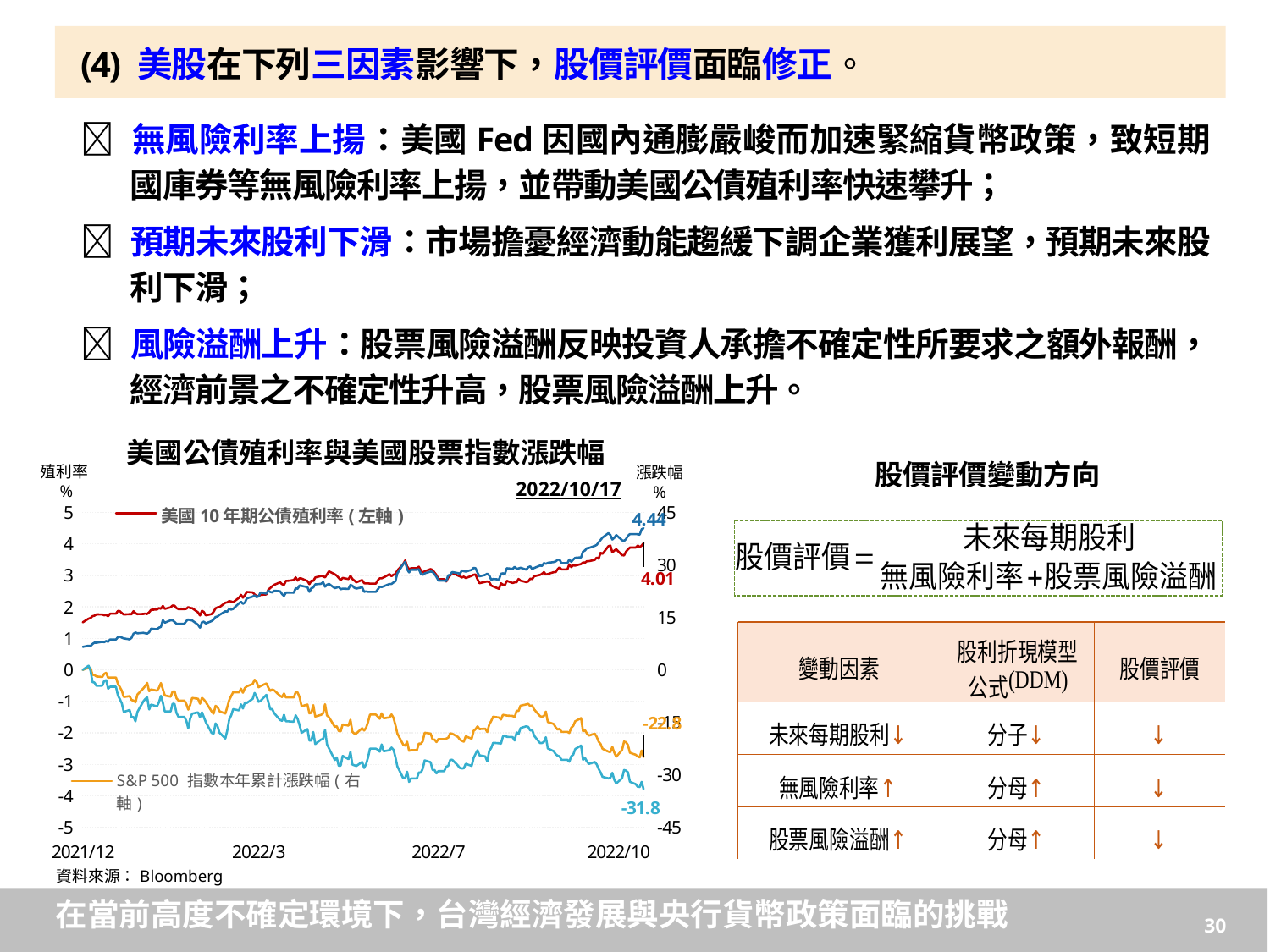
In the chart "美國公債殖利率與美國股票指數漲跌幅", is the S&P 500 指數本年累計漲跌幅 at 2022/10 greater or less than -15 on the right axis? less In the chart "美國公債殖利率與美國股票指數漲跌幅", what value is labelled for 美國 10 年期公債殖利率 at 2022/10/17? 4.01 What is the data source given for the chart "美國公債殖利率與美國股票指數漲跌幅"? Bloomberg What kind of chart is "美國公債殖利率與美國股票指數漲跌幅"? line chart How many date labels are shown on the x axis of the chart "美國公債殖利率與美國股票指數漲跌幅"? 4 What date is annotated at the right end of the chart "美國公債殖利率與美國股票指數漲跌幅"? 2022/10/17 In the chart "美國公債殖利率與美國股票指數漲跌幅", does the 美國 10 年期公債殖利率 line generally rise or fall from 2021/12 to 2022/10? rise In the chart "美國公債殖利率與美國股票指數漲跌幅", is the 美國 10 年期公債殖利率 at 2022/10/17 greater or less than 4? greater In the chart "美國公債殖利率與美國股票指數漲跌幅", does the S&P 500 指數本年累計漲跌幅 line generally rise or fall from 2021/12 to 2022/10? fall In the chart "美國公債殖利率與美國股票指數漲跌幅", is the 美國 10 年期公債殖利率 at the start of the period (2021/12) greater or less than 2? less